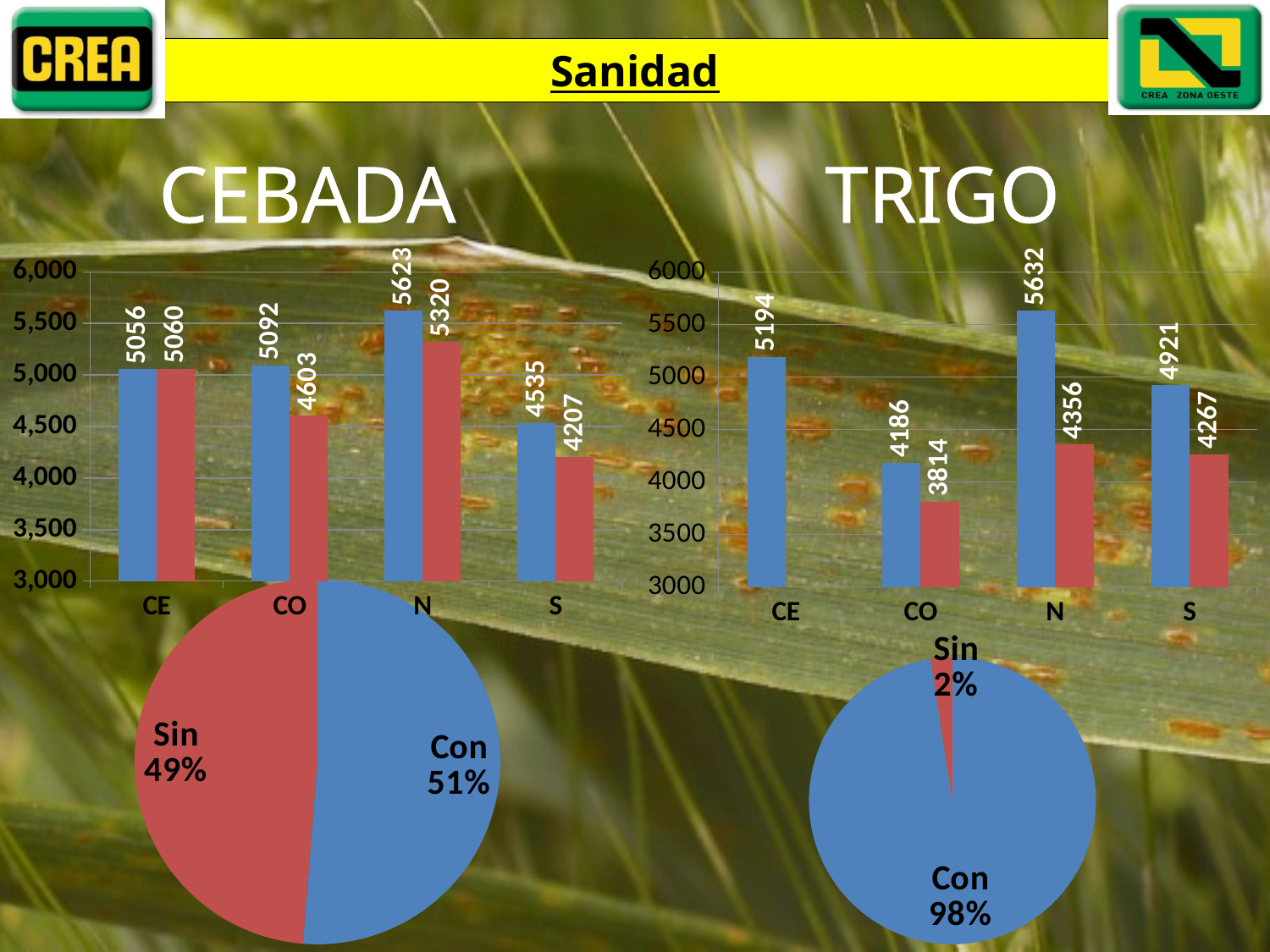
In the TRIGO pie chart, what share does the Con slice have? 98% In the CEBADA bar chart, what is the difference between the blue and red bars for S? 328 In the CEBADA pie chart, what share does the Sin slice have? 49% What kind of chart is shown at the bottom right of the slide, under TRIGO? pie chart In the TRIGO bar chart, which category has the highest blue bar? N In the TRIGO bar chart, what is the value of the blue bar for CE? 5194 In the TRIGO bar chart, which is larger for N: the blue bar or the red bar? the blue bar In the CEBADA bar chart, what is the value of the blue bar for N? 5623 How many categories are shown on the x axis of the CEBADA bar chart? 4 In the TRIGO bar chart, what is the value of the red bar for CO? 3814 In the CEBADA bar chart, what is the value of the red bar for CO? 4603 In the CEBADA bar chart, which category has the lowest red bar? S